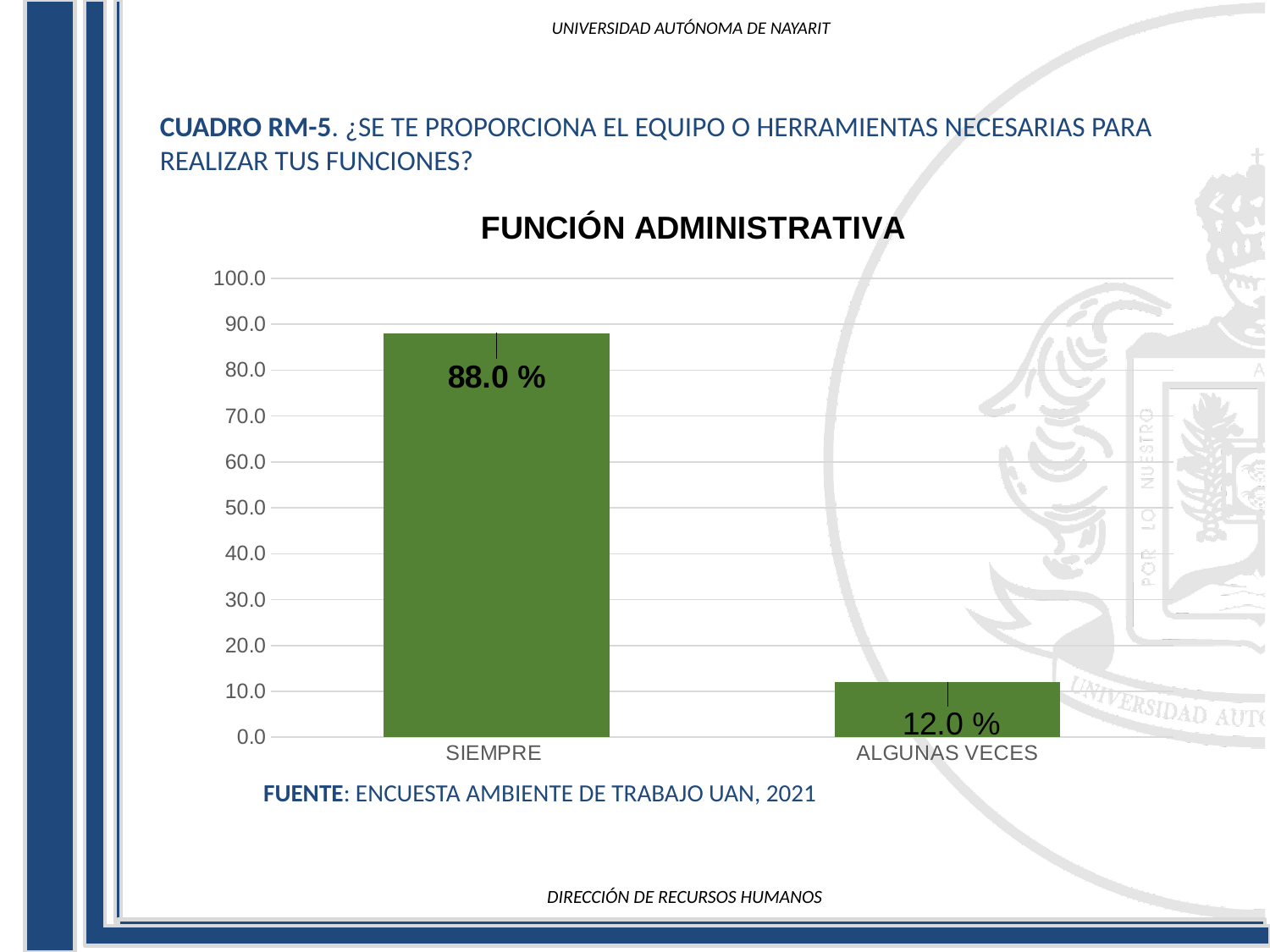
Which category has the lowest value? ALGUNAS VECES Which is larger, the value for SIEMPRE or the value for ALGUNAS VECES? SIEMPRE How many categories are shown on the x axis? 2 What is the value for SIEMPRE? 88.0 % Is the value for SIEMPRE greater or less than 80.0? greater What is the title of the chart? FUNCIÓN ADMINISTRATIVA Is the value for ALGUNAS VECES greater or less than 20.0? less What is the difference between the values for SIEMPRE and ALGUNAS VECES? 76.0 % What is the highest value shown on the y axis? 100.0 What is the value for ALGUNAS VECES? 12.0 % What kind of chart is shown on the slide? bar chart Which category has the highest value? SIEMPRE